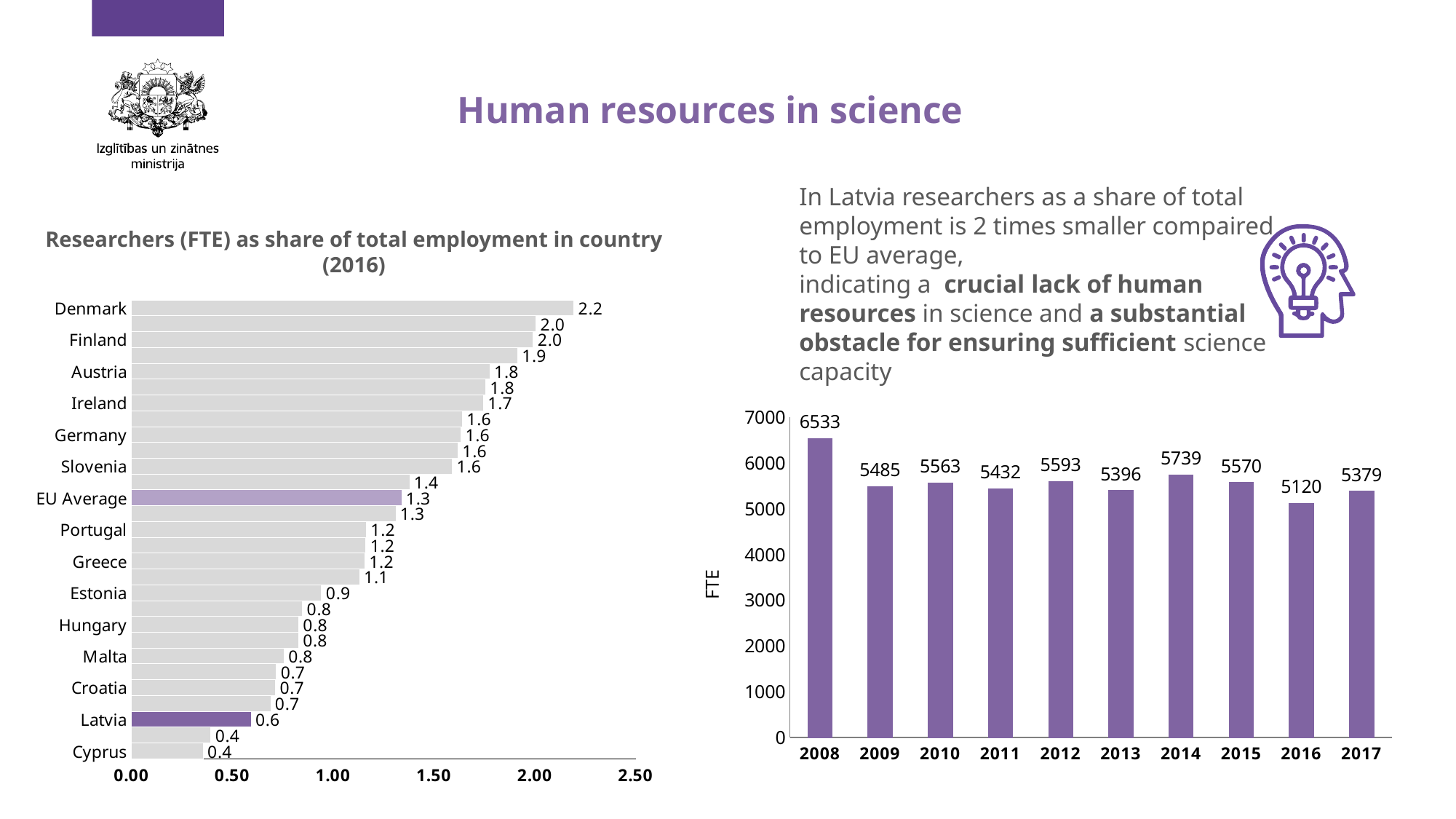
In the FTE chart on the right, what is the difference between the values for 2008 and 2017? 1154 In the chart 'Researchers (FTE) as share of total employment in country (2016)', what is the value for Latvia? 0.6 In the chart 'Researchers (FTE) as share of total employment in country (2016)', what is the value for EU Average? 1.3 In the chart 'Researchers (FTE) as share of total employment in country (2016)', which labelled country has the lowest value? Cyprus In the chart 'Researchers (FTE) as share of total employment in country (2016)', which labelled country has the highest value? Denmark In the chart 'Researchers (FTE) as share of total employment in country (2016)', what is the difference between the EU Average and Latvia? 0.7 What type of chart is the chart on the right of the slide showing FTE by year? Bar chart How many years are shown in the FTE chart on the right? 10 In the chart 'Researchers (FTE) as share of total employment in country (2016)', what is the value for Denmark? 2.2 In the chart 'Researchers (FTE) as share of total employment in country (2016)', which is larger, the value for Estonia or the value for Hungary? Estonia In the FTE chart on the right, which year has the lowest value? 2016 In the FTE chart on the right, what is the value for 2008? 6533